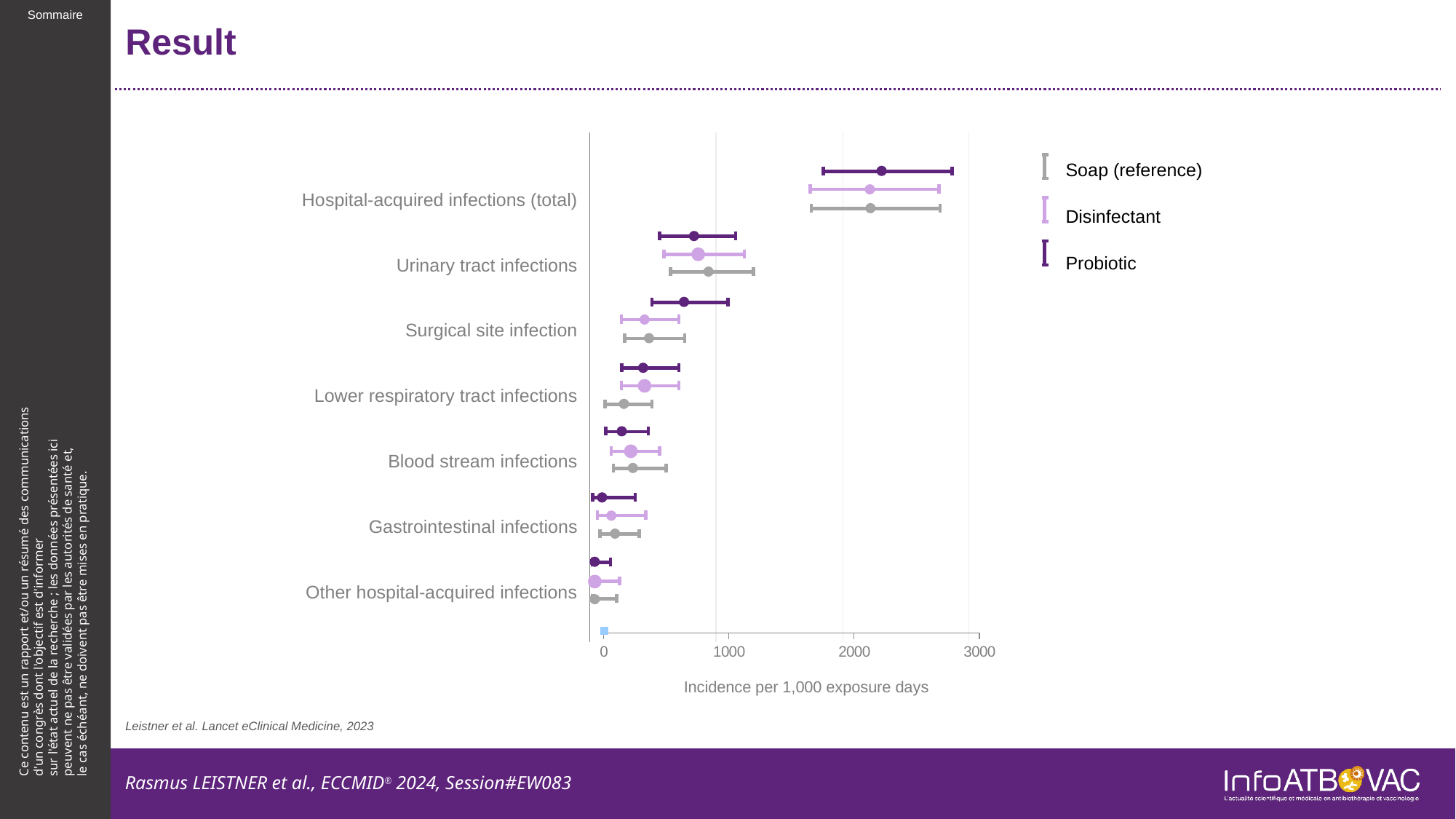
Which is larger, the Probiotic value for Lower respiratory tract infections or the Soap (reference) value for Lower respiratory tract infections? Probiotic Is the Disinfectant value for Blood stream infections greater or less than 1000? less Is the Probiotic value for Hospital-acquired infections (total) greater or less than 2000? greater Which category has the lowest incidence values in the chart? Other hospital-acquired infections What kind of chart is shown on the slide? Dot plot with error bars Is the Soap (reference) value for Urinary tract infections greater or less than 1000? less Which category has the highest incidence values in the chart? Hospital-acquired infections (total) Which series is marked as the reference in the legend? Soap (reference) Which is larger, the Probiotic value for Surgical site infection or the Disinfectant value for Surgical site infection? Probiotic How many infection categories are listed on the y axis of the chart? 7 What is the label of the x axis of the chart? Incidence per 1,000 exposure days How many series does the legend list? 3